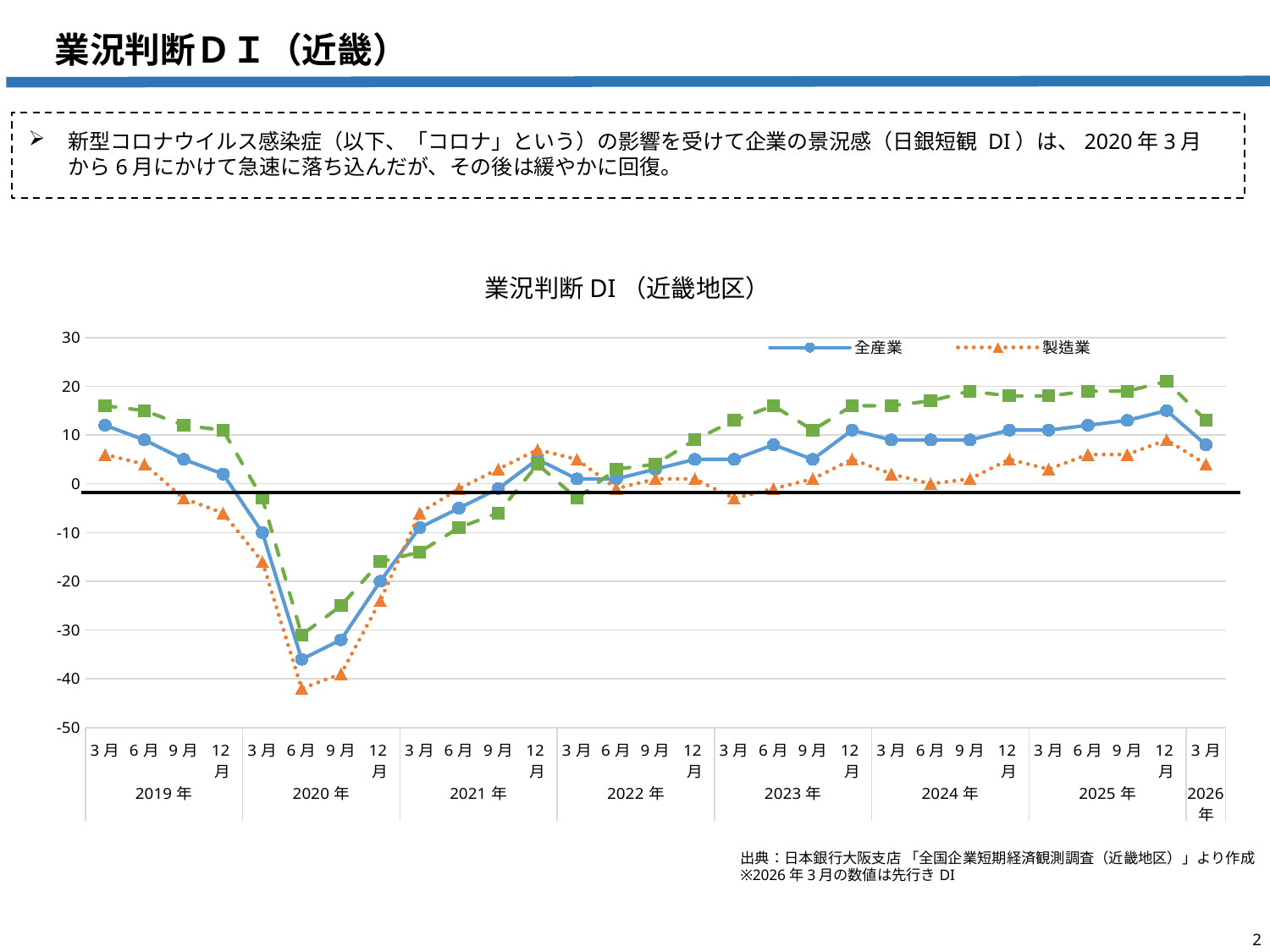
In 2020年6月, which series has the lower value, 全産業 or 製造業? 製造業 Is the 製造業 value for 2020年6月 greater or less than -30? less Is the 全産業 value for 2020年6月 greater or less than -30? less Is the 全産業 value for 2019年3月 greater or less than 10? greater What is the title of the chart? 業況判断DI（近畿地区） In which quarter does the 製造業 line reach its lowest value? 2020年6月 How many series does the chart legend list? 2 Which series are listed in the chart legend? 全産業 and 製造業 Does the 全産業 line rise or fall from 2020年3月 to 2020年6月? fall What kind of chart is shown on the slide? line chart In which quarter does the 全産業 line reach its lowest value? 2020年6月 In 2019年3月, which series has the higher value, 全産業 or 製造業? 全産業